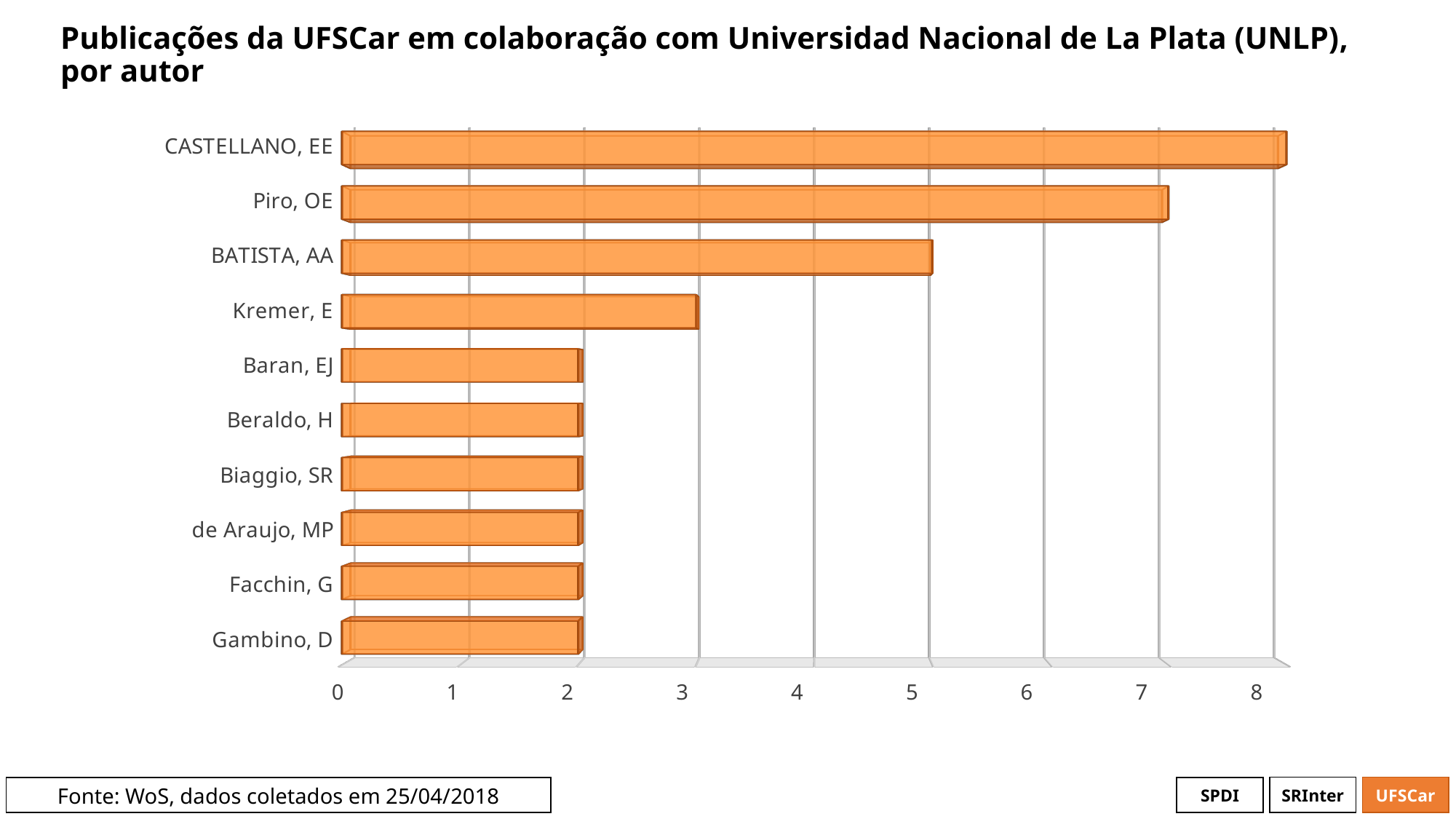
How many publications does CASTELLANO, EE have? 8 How many publications does Gambino, D have? 2 What kind of chart is shown on the slide? bar chart What is the title of the chart? Publicações da UFSCar em colaboração com Universidad Nacional de La Plata (UNLP), por autor How many publications does BATISTA, AA have? 5 How many publications does Kremer, E have? 3 Who has more publications, Piro, OE or BATISTA, AA? Piro, OE Which author has the highest number of publications? CASTELLANO, EE How many authors are listed on the chart? 10 What is the difference in publications between CASTELLANO, EE and Kremer, E? 5 Is the value for BATISTA, AA greater or less than 4? greater How many publications does Piro, OE have? 7